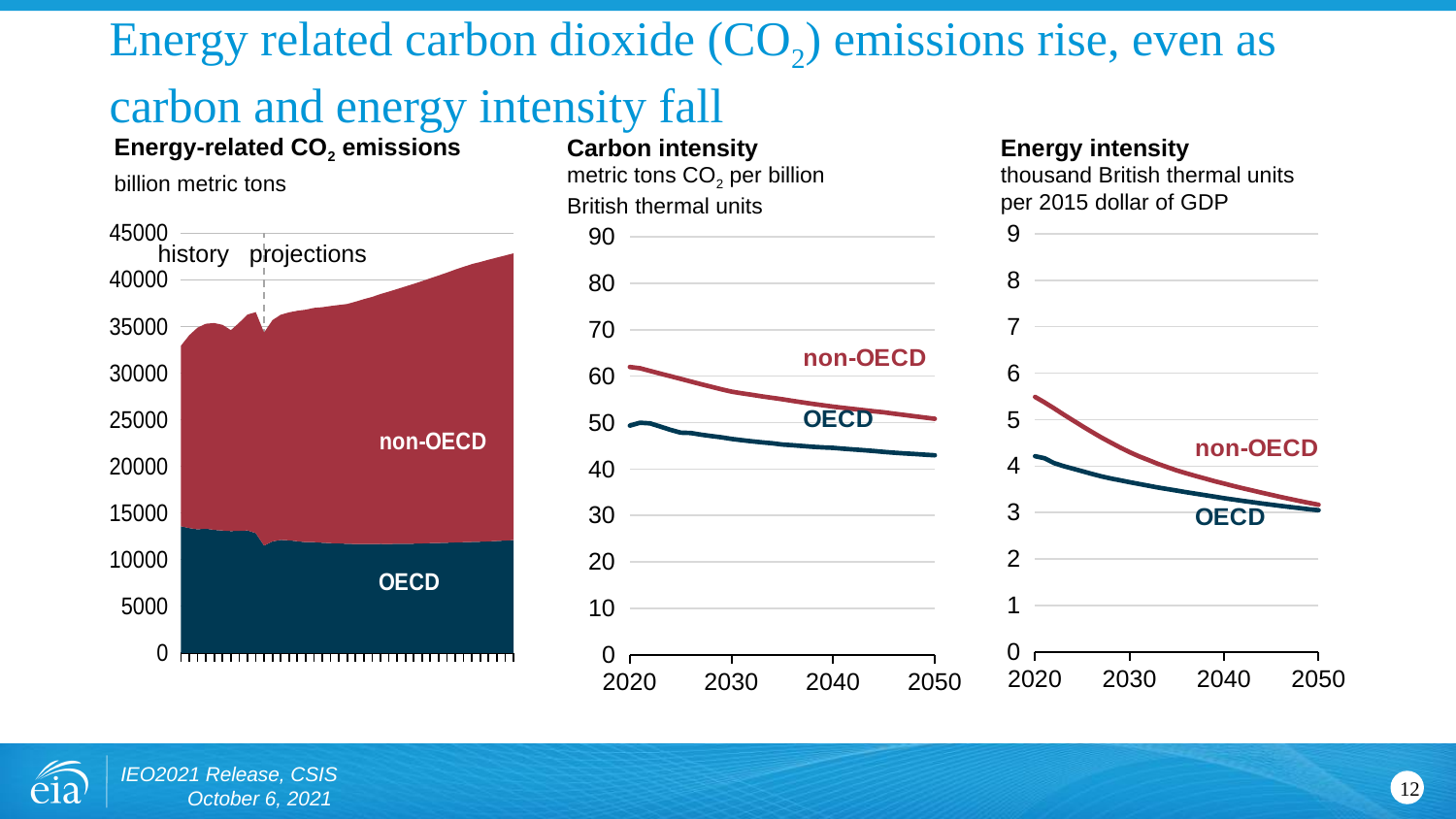
In the Energy intensity chart, is the non-OECD value in 2020 greater or less than 5? greater In the Carbon intensity chart, is the OECD value in 2050 greater or less than 50? less What unit is shown under the Energy intensity chart title? thousand British thermal units per 2015 dollar of GDP In the Energy-related CO2 emissions chart, do total emissions rise or fall over the projection period? rise In the Carbon intensity chart, which series is higher throughout, OECD or non-OECD? non-OECD In the Energy-related CO2 emissions chart, is the total emissions value in 2050 greater or less than 40000? greater In the Carbon intensity chart, how many series are plotted? 2 In the Energy-related CO2 emissions chart, which region accounts for the larger share of emissions, OECD or non-OECD? non-OECD What kind of chart is the Energy-related CO2 emissions chart? area chart What kind of chart is the Carbon intensity chart? line chart In the Energy intensity chart, does the non-OECD line rise or fall from 2020 to 2050? fall